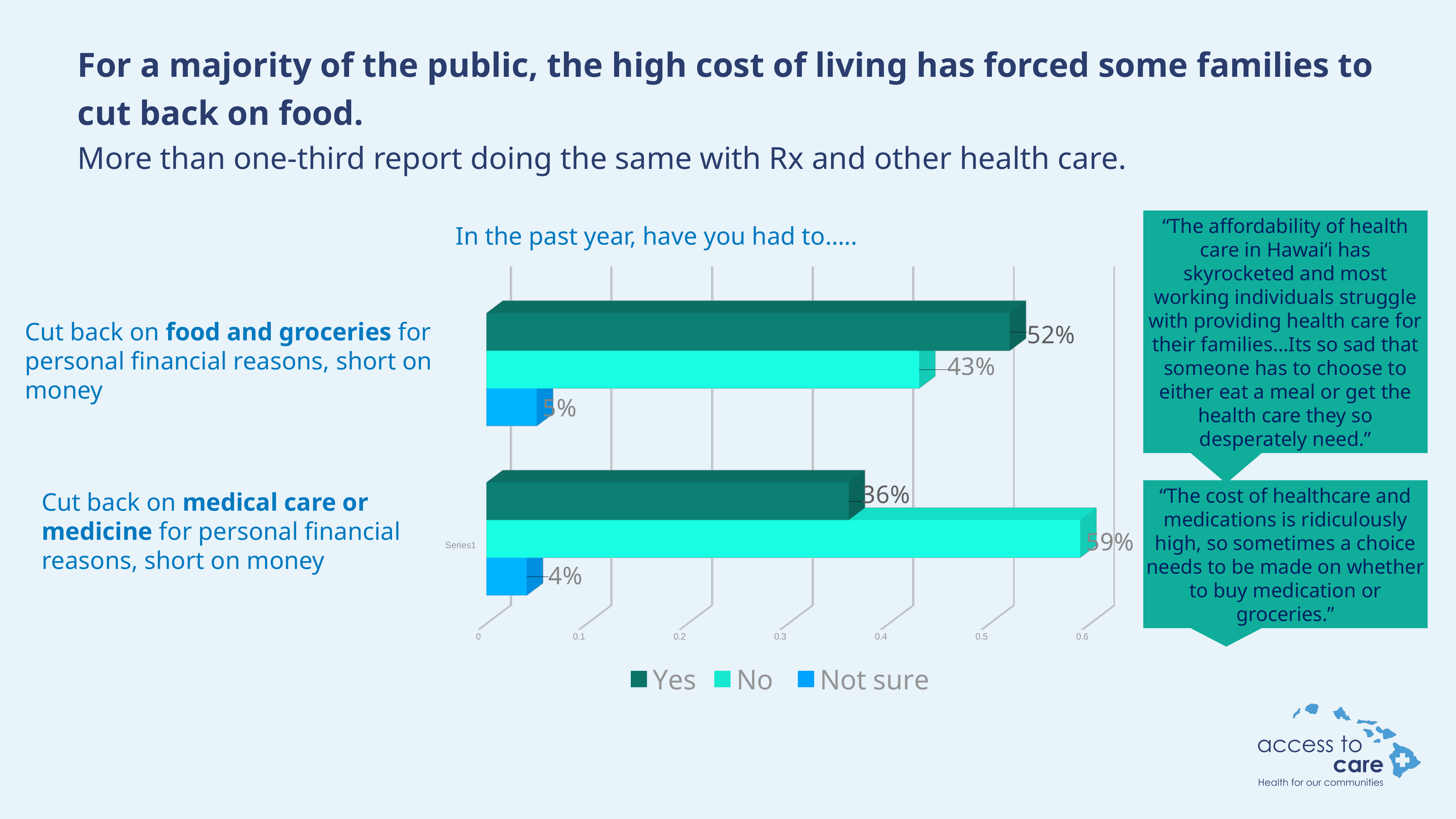
What percentage answered Yes to cutting back on food and groceries? 52% What percentage answered Not sure about cutting back on medical care or medicine? 4% Which is larger: the Yes value for food and groceries or the Yes value for medical care or medicine? Food and groceries What percentage answered Yes to cutting back on medical care or medicine? 36% How many series does the chart legend list? 3 What percentage answered No to cutting back on medical care or medicine? 59% What kind of chart is shown on the slide? Bar chart What percentage answered No to cutting back on food and groceries? 43% Which response has the lowest value for cutting back on food and groceries? Not sure What percentage answered Not sure about cutting back on food and groceries? 5% Which response has the highest value for cutting back on medical care or medicine? No What is the difference between the Yes values for food and groceries and for medical care or medicine? 16%